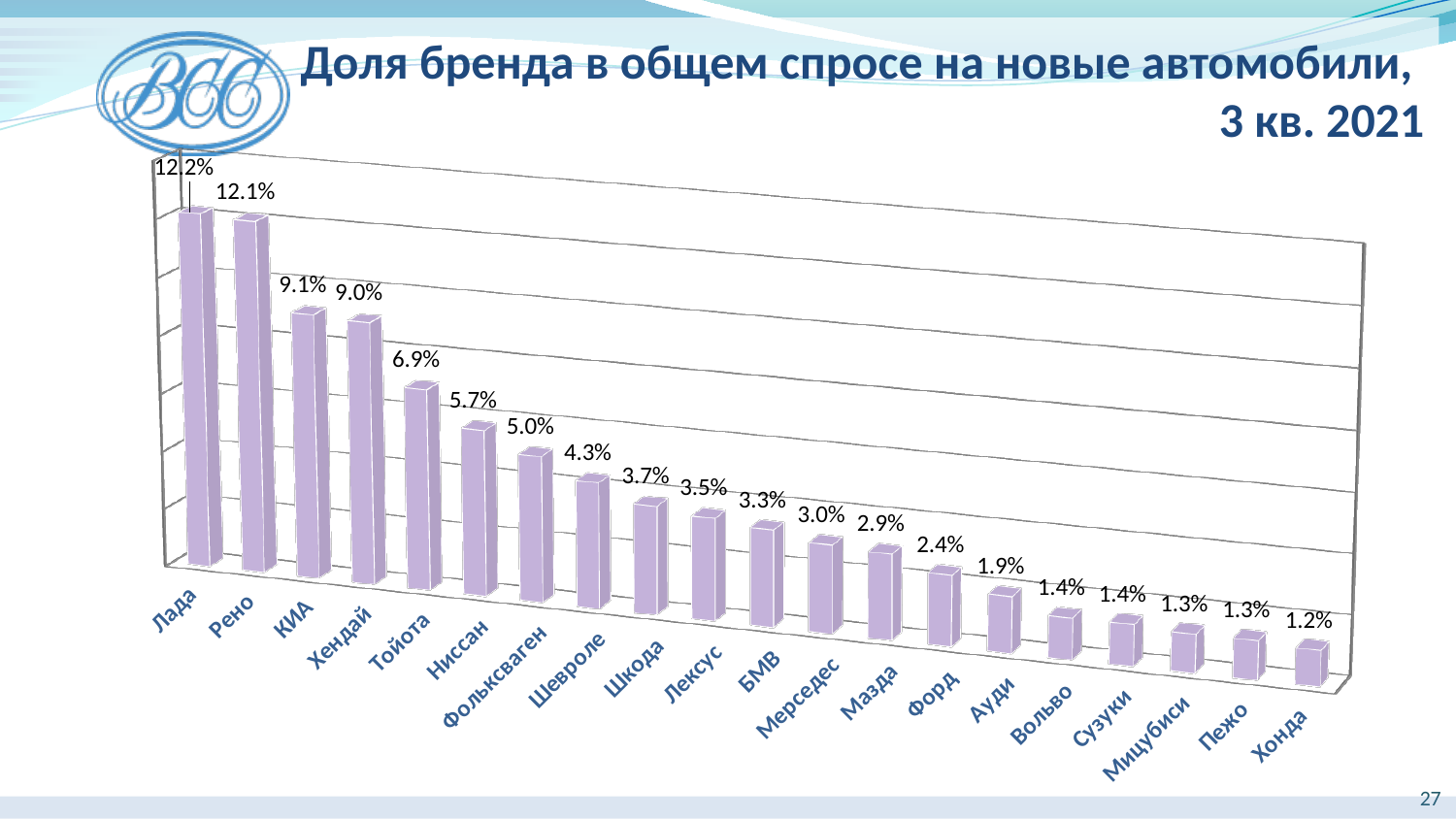
What is the value for Фольксваген? 5.0% What is the value for Мерседес? 3.0% Which is larger, the value for Хендай or the value for Тойота? Хендай What is the difference between the values for Ниссан and Шкода? 2.0% What kind of chart is shown on the slide? Bar chart How many brands are shown on the chart? 20 What is the value for Тойота? 6.9% Do the values rise or fall from left to right along the x axis? Fall What is the difference between the values for Лада and КИА? 3.1% What is the value for Хонда? 1.2% Which brand has the highest share? Лада Which brand has the lowest share? Хонда